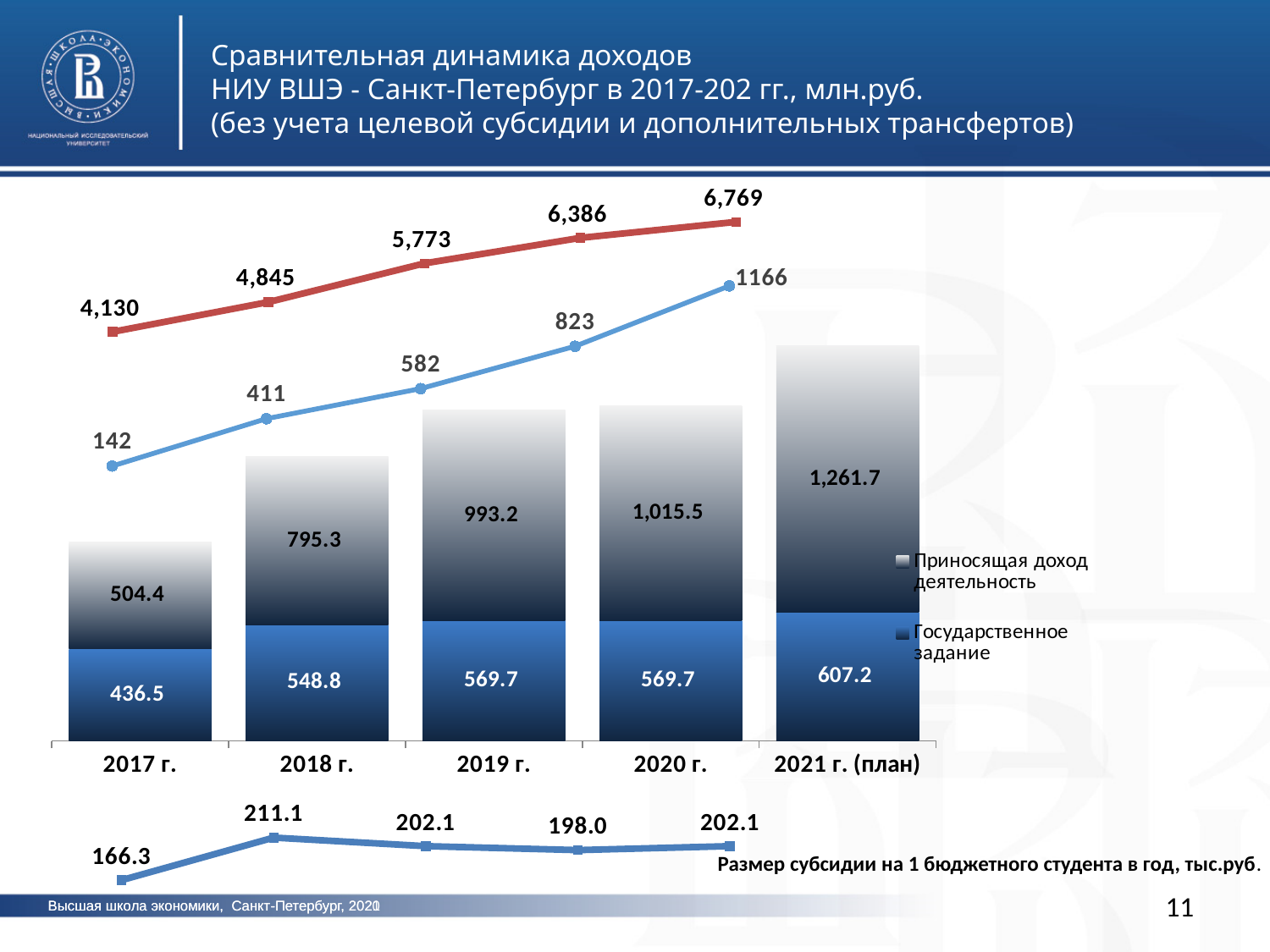
In the stacked bar chart, which year has the highest value for Государственное задание? 2021 г. (план) How many series does the legend of the stacked bar chart list? 2 In the stacked bar chart, does Приносящая доход деятельность rise or fall from 2017 г. to 2021 г. (план)? rises In the stacked bar chart, what is the value of Приносящая доход деятельность for 2021 г. (план)? 1,261.7 In the stacked bar chart, what is the value of Государственное задание for 2019 г.? 569.7 In the lower line chart 'Размер субсидии на 1 бюджетного студента в год, тыс.руб.', what is the difference between the last value (202.1) and the first value (166.3)? 35.8 In the stacked bar chart, what is the total of the 2017 г. bar (Государственное задание plus Приносящая доход деятельность)? 940.9 In the lower line chart 'Размер субсидии на 1 бюджетного студента в год, тыс.руб.', what is the highest value shown? 211.1 In the stacked bar chart, which year has the lowest value for Приносящая доход деятельность? 2017 г. In the main chart, what value does the red line show for 2019 г.? 5,773 How many years (categories) are shown on the x axis of the stacked bar chart? 5 In the stacked bar chart, what is the difference between Приносящая доход деятельность in 2021 г. (план) and in 2020 г.? 246.2